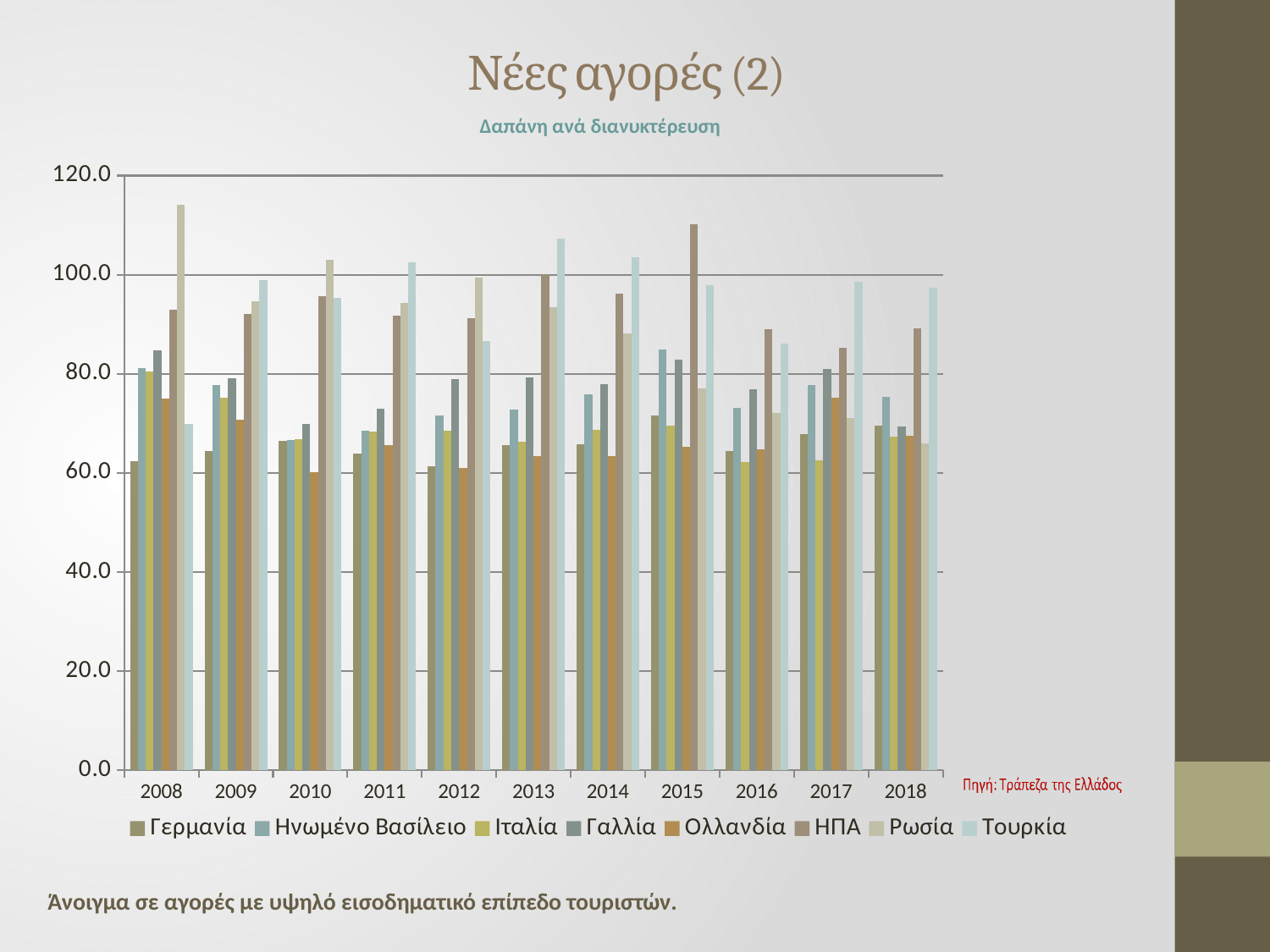
How many series does the legend list? 8 Do the values for Ρωσία rise or fall from 2008 to 2018? fall Is the value for Τουρκία in 2008 greater or less than 80? less In 2015, which is larger: the value for ΗΠΑ or the value for Γερμανία? ΗΠΑ Which country has the lowest value in 2008? Γερμανία Which country has the highest value in 2008? Ρωσία What kind of chart is shown on the slide? bar chart Which country has the highest value in 2015? ΗΠΑ Is the value for ΗΠΑ in 2018 greater or less than 80? greater Is the value for Ρωσία in 2008 greater or less than 100? greater What is the title of the chart? Δαπάνη ανά διανυκτέρευση How many years are shown on the x axis? 11